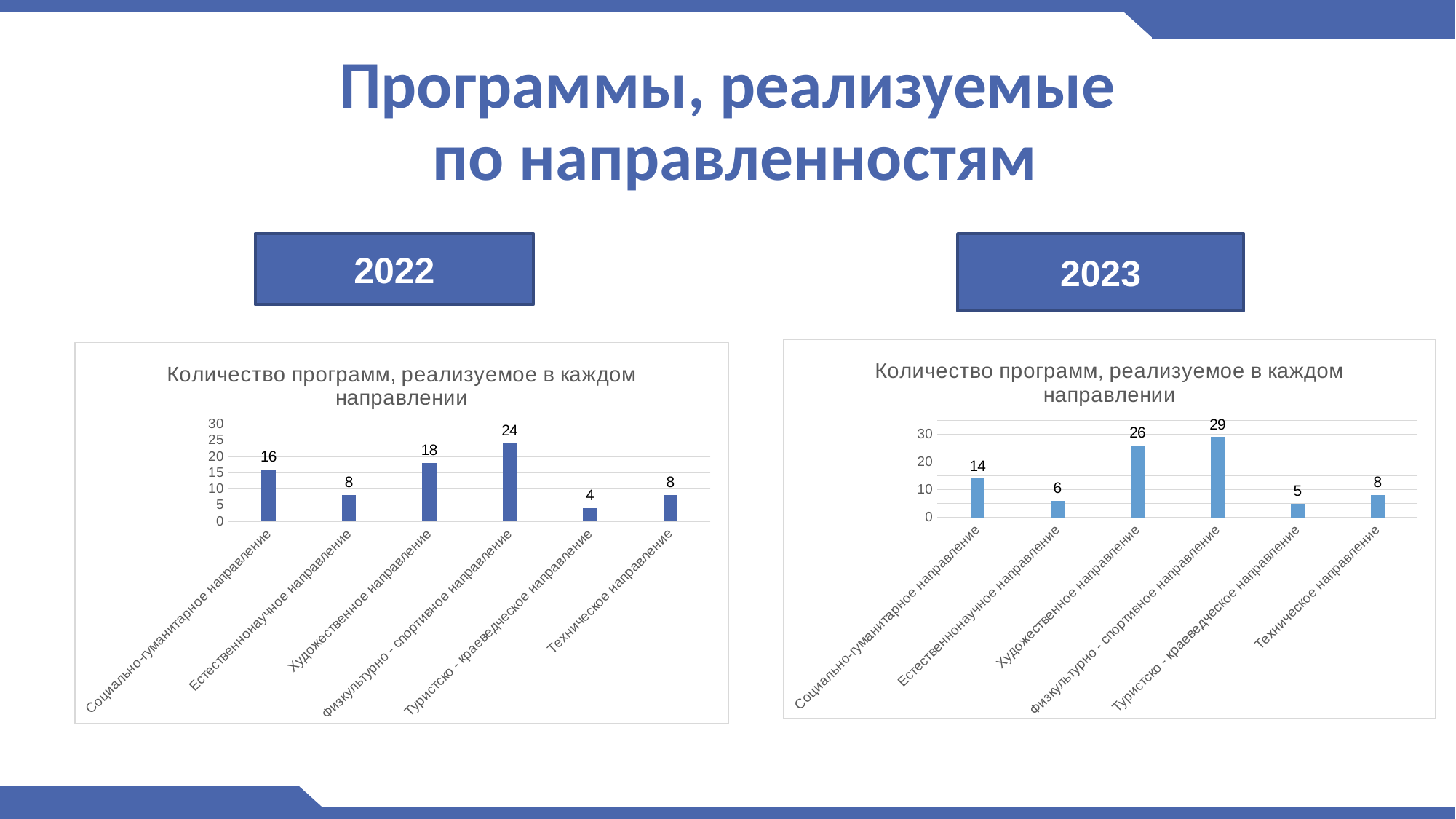
In the 2022 chart, what is the difference between Физкультурно - спортивное направление and Социально-гуманитарное направление? 8 In the 2023 chart, is the value for Физкультурно - спортивное направление greater or less than 20? greater In the 2022 chart, what is the value for Художественное направление? 18 How many categories are shown in the 2022 chart? 6 In the 2023 chart, what is the value for Социально-гуманитарное направление? 14 In the 2022 chart, which category has the lowest value? Туристско - краеведческое направление In the 2023 chart, which category has the lowest value? Туристско - краеведческое направление What is the title of the 2022 chart? Количество программ, реализуемое в каждом направлении In the 2022 chart, which category has the highest value? Физкультурно - спортивное направление In the 2023 chart, which is larger: Естественнонаучное направление or Техническое направление? Техническое направление What type of chart is the 2023 chart? Bar chart In the 2023 chart, what is the difference between Физкультурно - спортивное направление and Художественное направление? 3